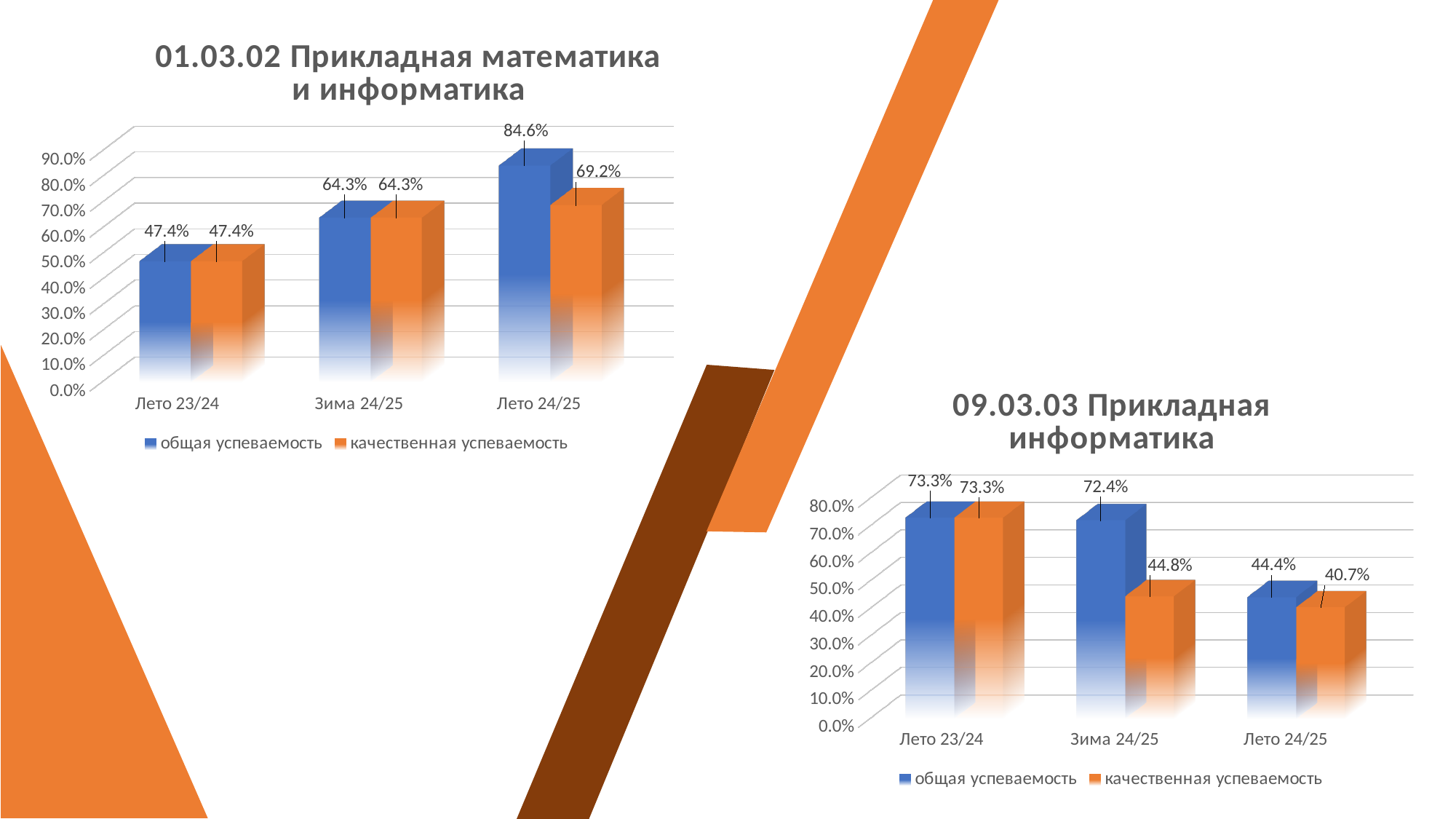
In the chart titled "01.03.02 Прикладная математика и информатика", what is the value of качественная успеваемость for Зима 24/25? 64.3% How many series does the legend of the chart titled "09.03.03 Прикладная информатика" list? 2 In the chart titled "01.03.02 Прикладная математика и информатика", does общая успеваемость rise or fall from Лето 23/24 to Лето 24/25? rise In the chart titled "09.03.03 Прикладная информатика", what is the difference between общая успеваемость and качественная успеваемость for Зима 24/25? 27.6% In the chart titled "01.03.02 Прикладная математика и информатика", which category has the lowest общая успеваемость? Лето 23/24 In the chart titled "09.03.03 Прикладная информатика", which category has the highest качественная успеваемость? Лето 23/24 In the chart titled "09.03.03 Прикладная информатика", what is the value of качественная успеваемость for Зима 24/25? 44.8% In the chart titled "09.03.03 Прикладная информатика", which is larger: общая успеваемость for Зима 24/25 or общая успеваемость for Лето 24/25? Зима 24/25 In the chart titled "09.03.03 Прикладная информатика", what is the value of общая успеваемость for Лето 24/25? 44.4% In the chart titled "01.03.02 Прикладная математика и информатика", what is the difference between общая успеваемость and качественная успеваемость for Лето 24/25? 15.4% What kind of chart is the chart titled "01.03.02 Прикладная математика и информатика"? bar chart In the chart titled "01.03.02 Прикладная математика и информатика", what is the value of общая успеваемость for Лето 24/25? 84.6%